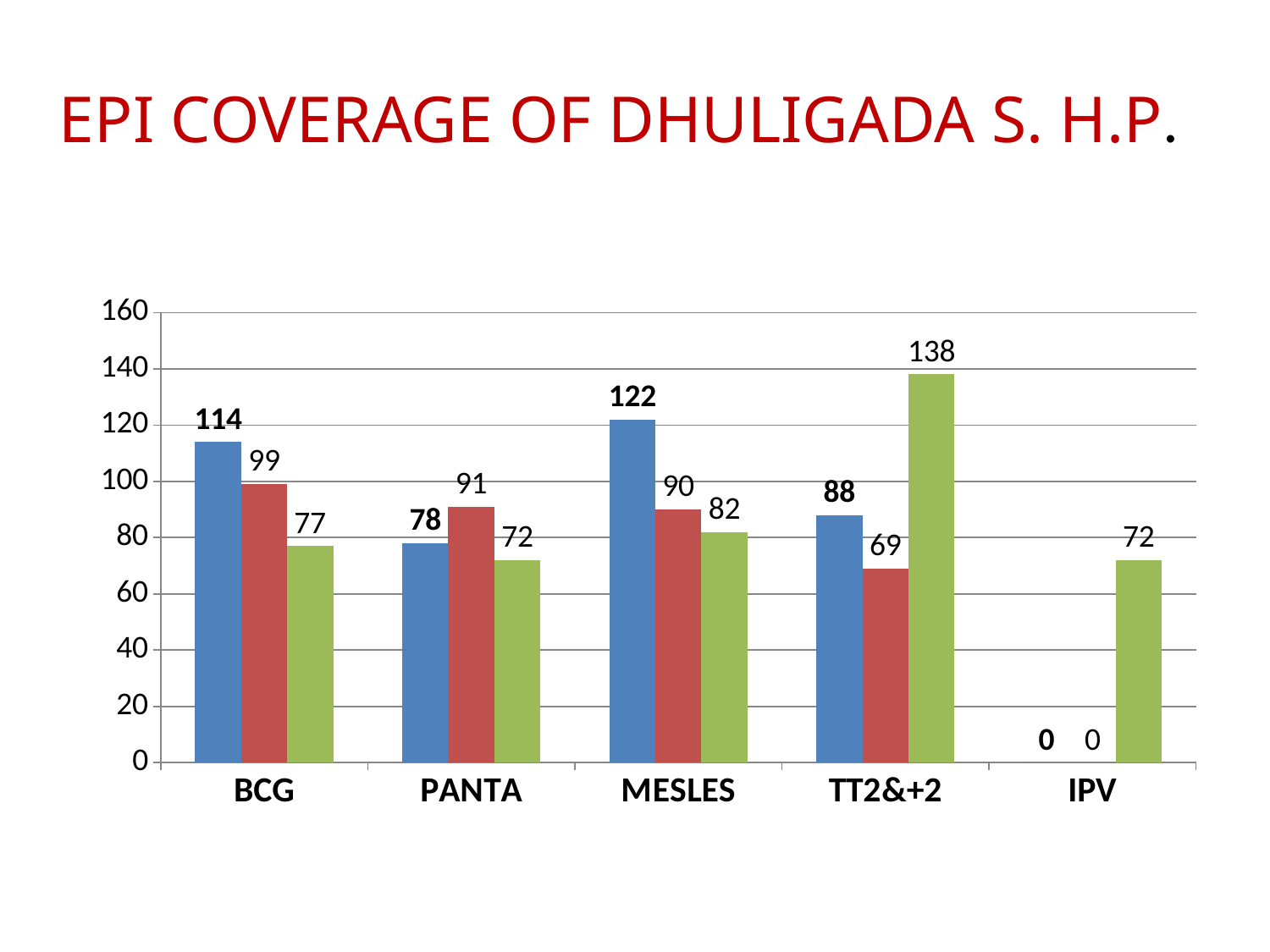
Which is larger for MESLES, the red bar or the green bar? the red bar What is the value of the green bar for IPV? 72 What is the title of the slide? EPI COVERAGE OF DHULIGADA S. H.P. What is the value of the blue bar for BCG? 114 What is the value of the red bar for PANTA? 91 What is the difference between the blue bar and the green bar for BCG? 37 How many categories are shown on the x axis? 5 Which category has the highest blue bar? MESLES What is the value of the blue bar for IPV? 0 What kind of chart is shown on the slide? bar chart What is the value of the green bar for TT2&+2? 138 Which category has the lowest red bar? IPV